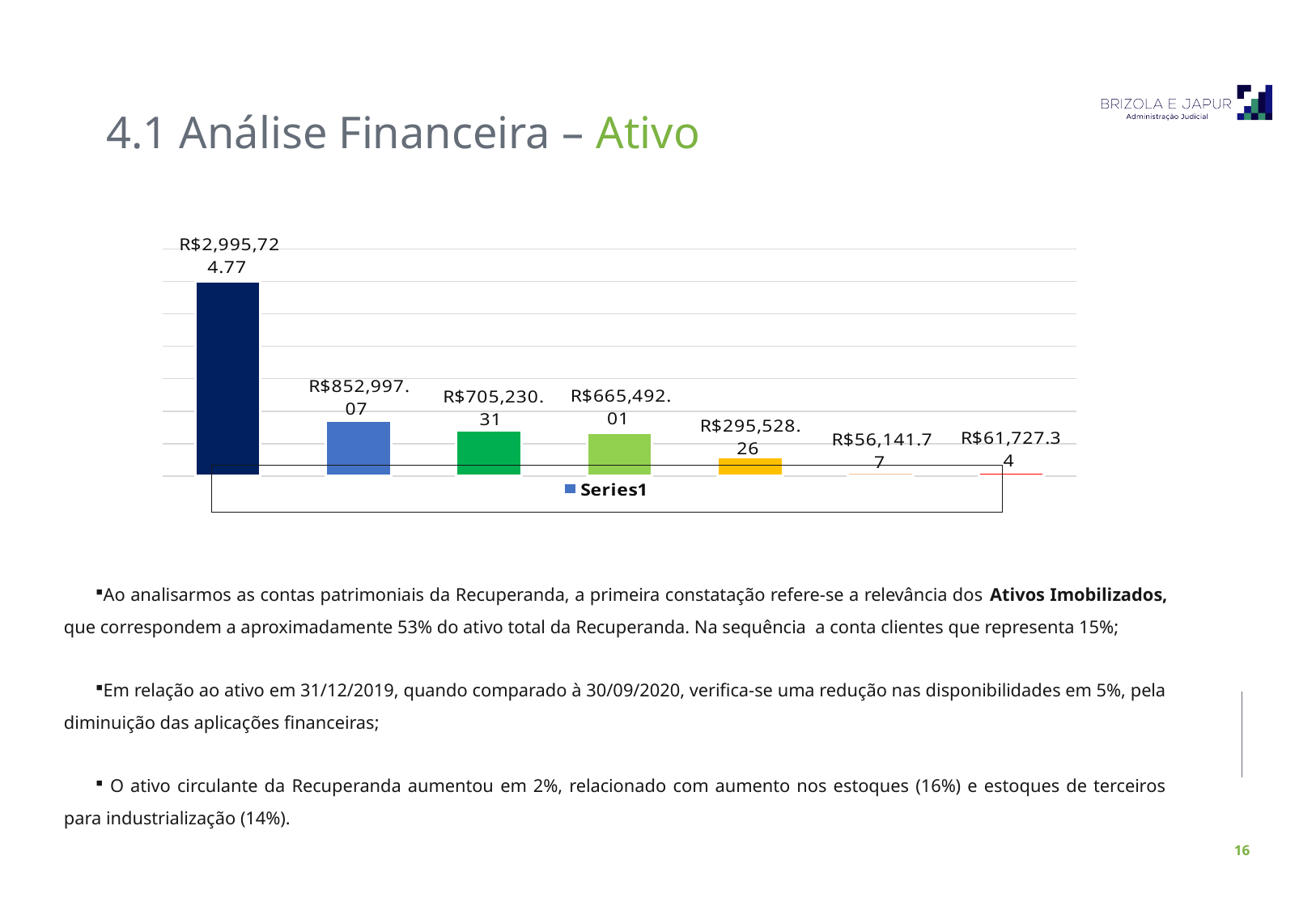
How many bars are plotted in the chart? 7 What is the value shown on the tallest bar in the chart? R$2,995,724.77 What is the value labelled on the yellow bar? R$295,528.26 What is the difference between the second bar (R$852,997.07) and the third bar (R$705,230.31)? R$147,766.76 What is the value labelled on the second bar from the left (the medium blue bar)? R$852,997.07 What is the smallest value labelled in the chart? R$56,141.77 What kind of chart is shown on the slide? bar chart What is the value labelled on the light green bar (fourth from the left)? R$665,492.01 What is the name of the series shown in the chart legend? Series1 How many series does the chart legend list? 1 What colour is the tallest bar in the chart? dark navy blue Which is larger, the value of the sixth bar (R$56,141.77) or the seventh bar (R$61,727.34)? R$61,727.34